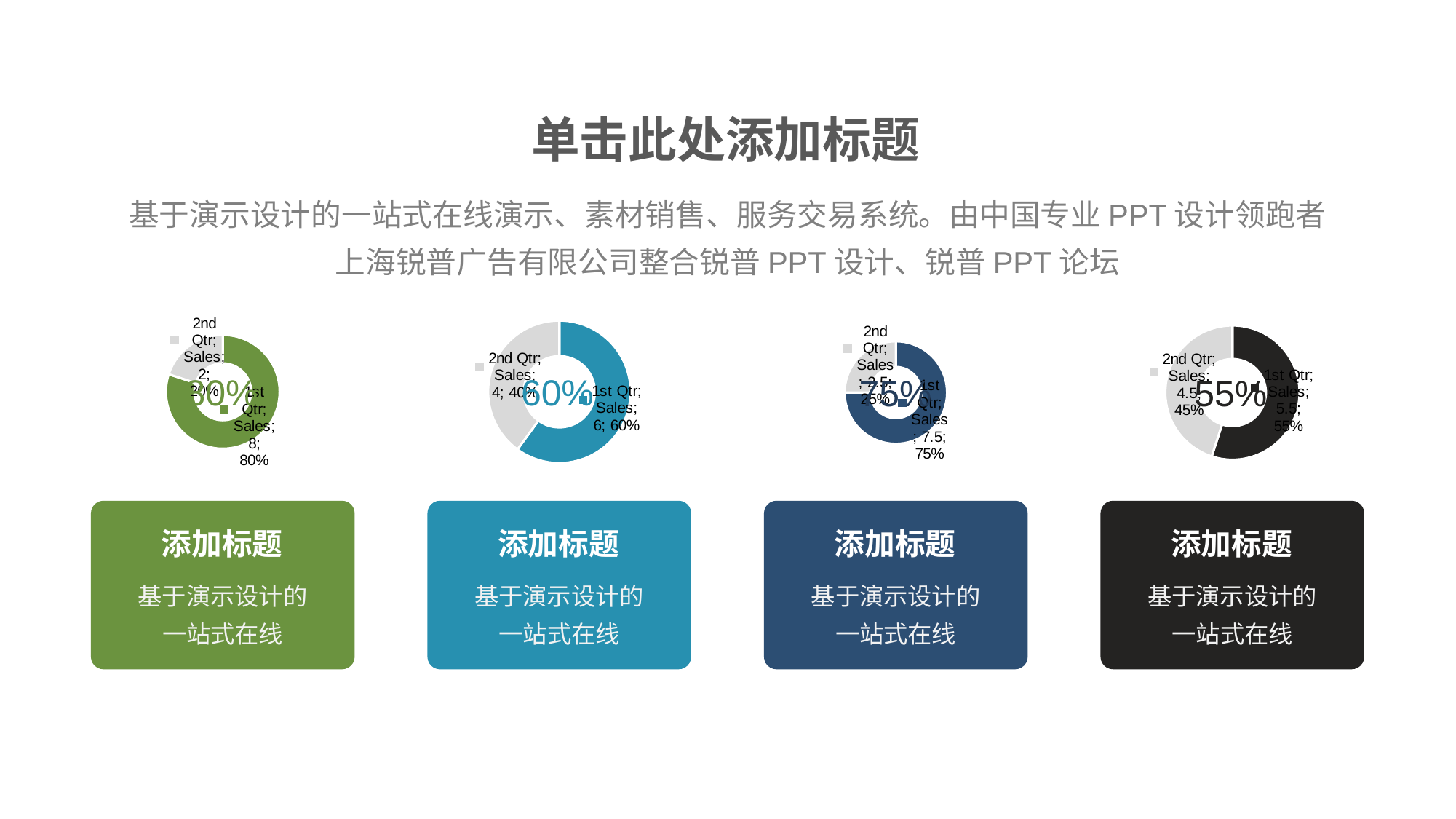
In the leftmost (green) doughnut chart, what percentage share does 2nd Qtr have? 20% What kind of chart is the second chart from the left (blue)? Doughnut chart How many doughnut charts are shown on the slide? 4 In the rightmost (black) doughnut chart, what is the value for 2nd Qtr? 4.5 In the second chart from the left (blue), what percentage share does 1st Qtr have? 60% In the third chart from the left (dark blue), what is the difference between the 1st Qtr and 2nd Qtr values? 5 In the third chart from the left (dark blue), what is the value for 1st Qtr? 7.5 In the second chart from the left (blue), what is the value for 2nd Qtr? 4 In the rightmost (black) doughnut chart, which category is larger, 1st Qtr or 2nd Qtr? 1st Qtr In the leftmost (green) doughnut chart, what is the value for 1st Qtr? 8 How many categories does the leftmost (green) doughnut chart show? 2 In the rightmost (black) doughnut chart, what percentage share does 2nd Qtr have? 45%